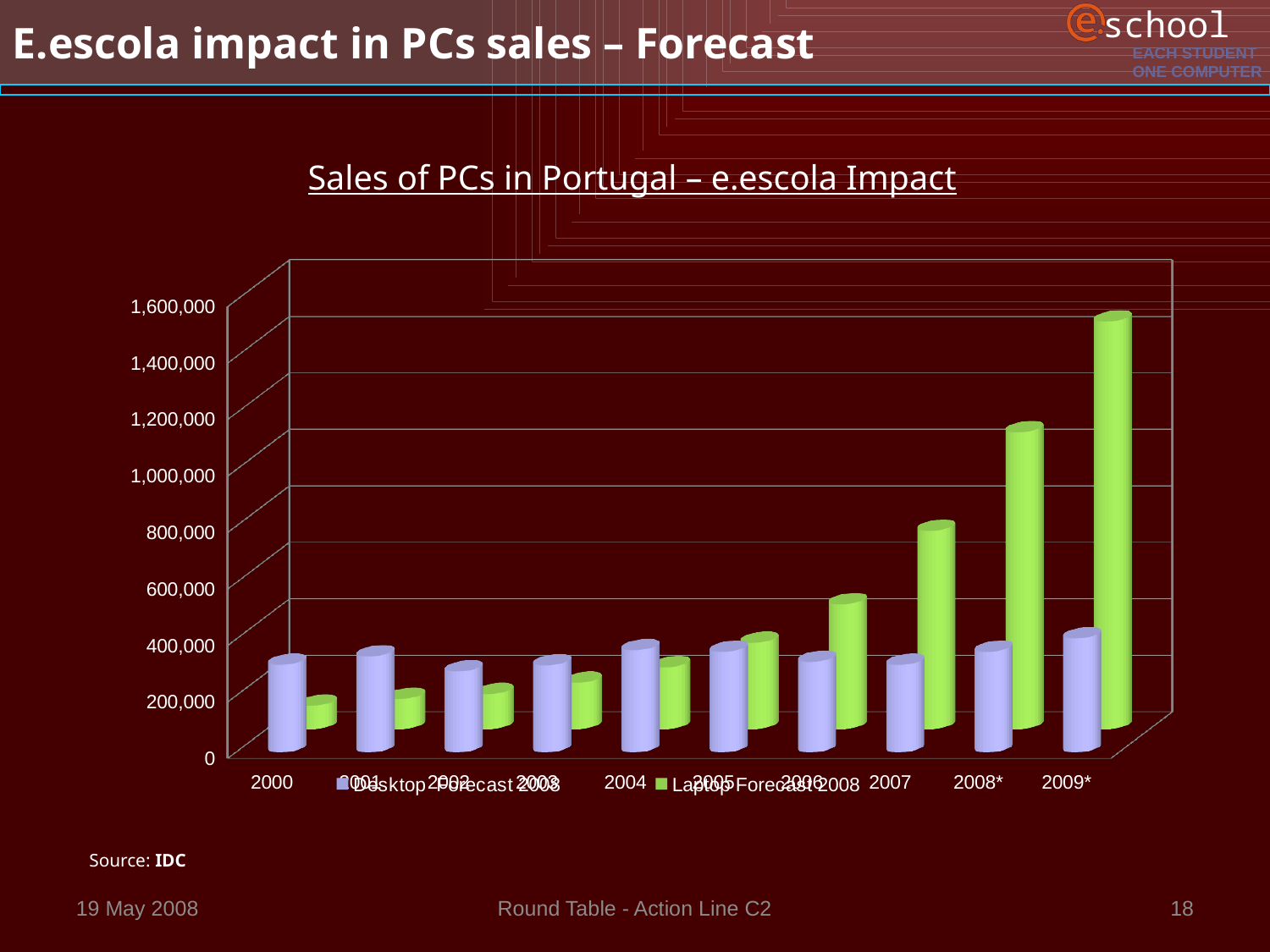
Is the Laptop Forecast 2008 value for 2000 greater or less than 200,000? less What is the title of the chart? Sales of PCs in Portugal – e.escola Impact Which year has the highest Laptop Forecast 2008 value? 2009* How many year categories are shown on the x axis? 10 Which year has the lowest Laptop Forecast 2008 value? 2000 Is the Laptop Forecast 2008 value for 2007 greater or less than 600,000? greater How many series does the legend list? 2 In 2009*, which series has the larger value, Desktop Forecast 2008 or Laptop Forecast 2008? Laptop Forecast 2008 Is the Laptop Forecast 2008 value for 2009* greater or less than 1,200,000? greater What kind of chart is shown on the slide? bar chart Do the Laptop Forecast 2008 values generally rise or fall from 2000 to 2009*? rise